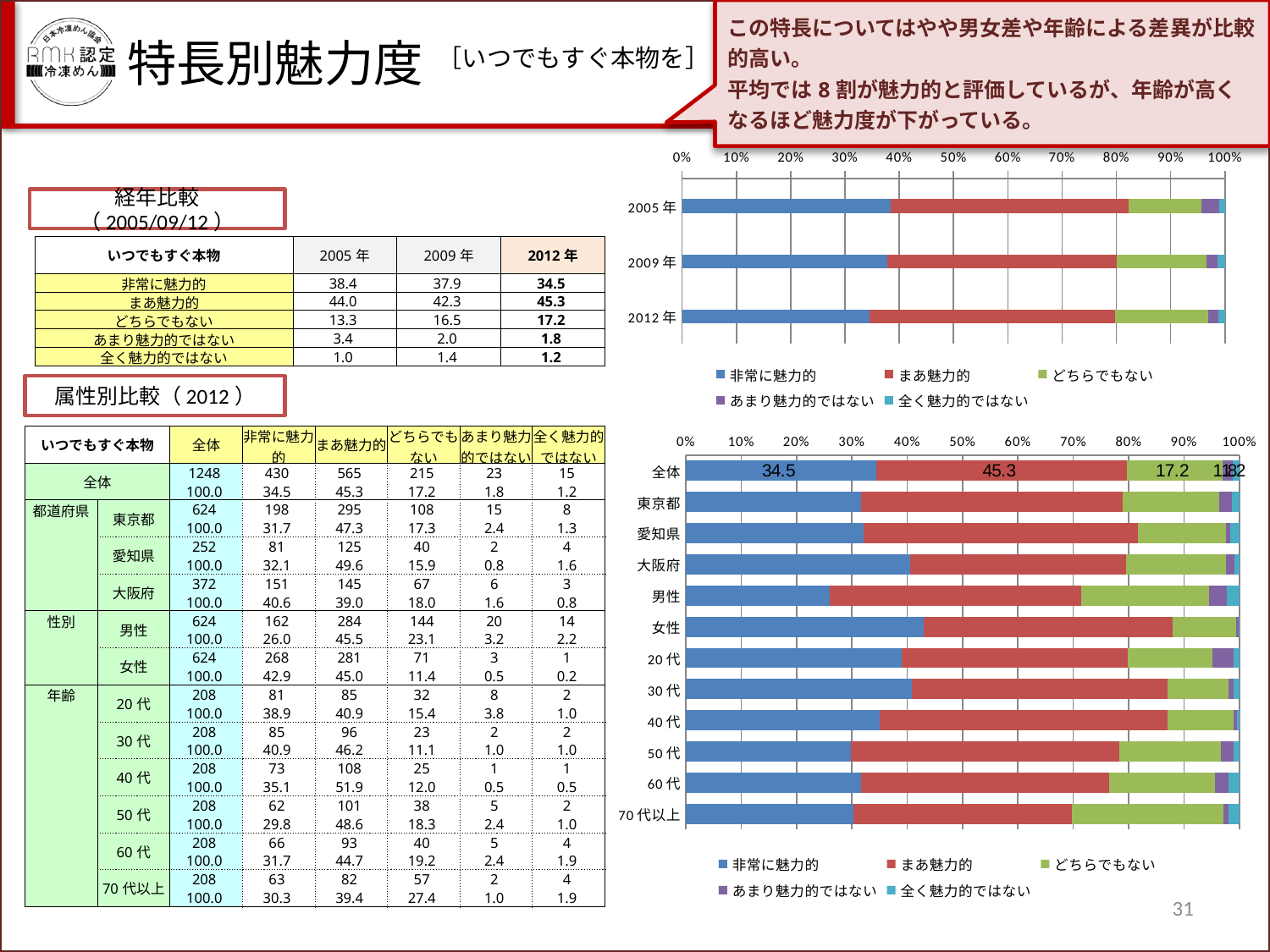
In the upper chart, does the 非常に魅力的 segment get longer or shorter from 2005年 to 2012年? shorter In the lower chart, what is the data label for 非常に魅力的 on the 全体 bar? 34.5 In the lower chart, what is the data label for まあ魅力的 on the 全体 bar? 45.3 In the lower chart, what is the difference between the まあ魅力的 and 非常に魅力的 labels on the 全体 bar? 10.8 What kind of chart is the upper chart on the right (the one with 2005年, 2009年, 2012年)? Stacked bar chart How many categories (bars) does the lower chart (全体 through 70代以上) show? 12 In the lower chart, which category has the shortest 非常に魅力的 segment? 男性 In the lower chart, what is the data label for どちらでもない on the 全体 bar? 17.2 How many categories (bars) does the upper chart with 2005年, 2009年 and 2012年 show? 3 How many series does the legend of the upper chart (2005年–2012年) list? 5 In the lower chart, is the 非常に魅力的 segment for 女性 greater or less than 40%? greater In the lower chart, is the 非常に魅力的 segment for 男性 greater or less than 30%? less